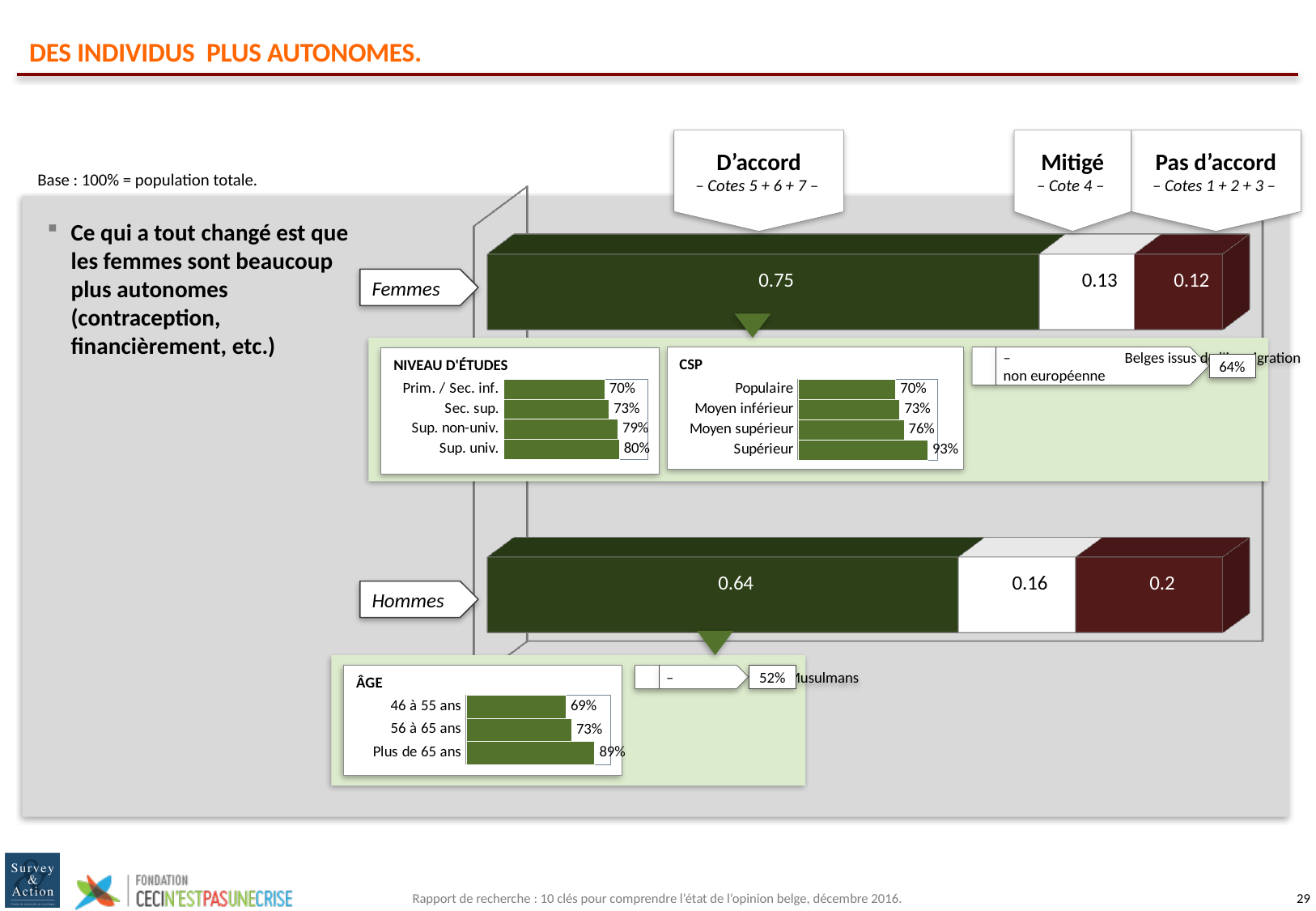
What kind of chart is the NIVEAU D'ÉTUDES chart? Bar chart In the CSP chart, what is the value for Moyen supérieur? 76% In the Hommes stacked bar, what is the value for Pas d'accord? 0.2 In the Hommes stacked bar, what is the value for Mitigé? 0.16 In the NIVEAU D'ÉTUDES chart, which category has the lowest value? Prim. / Sec. inf. In the Femmes stacked bar, what is the value for D'accord? 0.75 In the CSP chart, which category has the highest value? Supérieur In the ÂGE chart, what is the difference between Plus de 65 ans and 46 à 55 ans? 20% In the ÂGE chart, how many categories are shown? 3 In the NIVEAU D'ÉTUDES chart, what is the value for Sup. univ.? 80% Which is larger: the D'accord value for Femmes or the D'accord value for Hommes? Femmes What is the difference between the D'accord values for Femmes (0.75) and Hommes (0.64)? 0.11